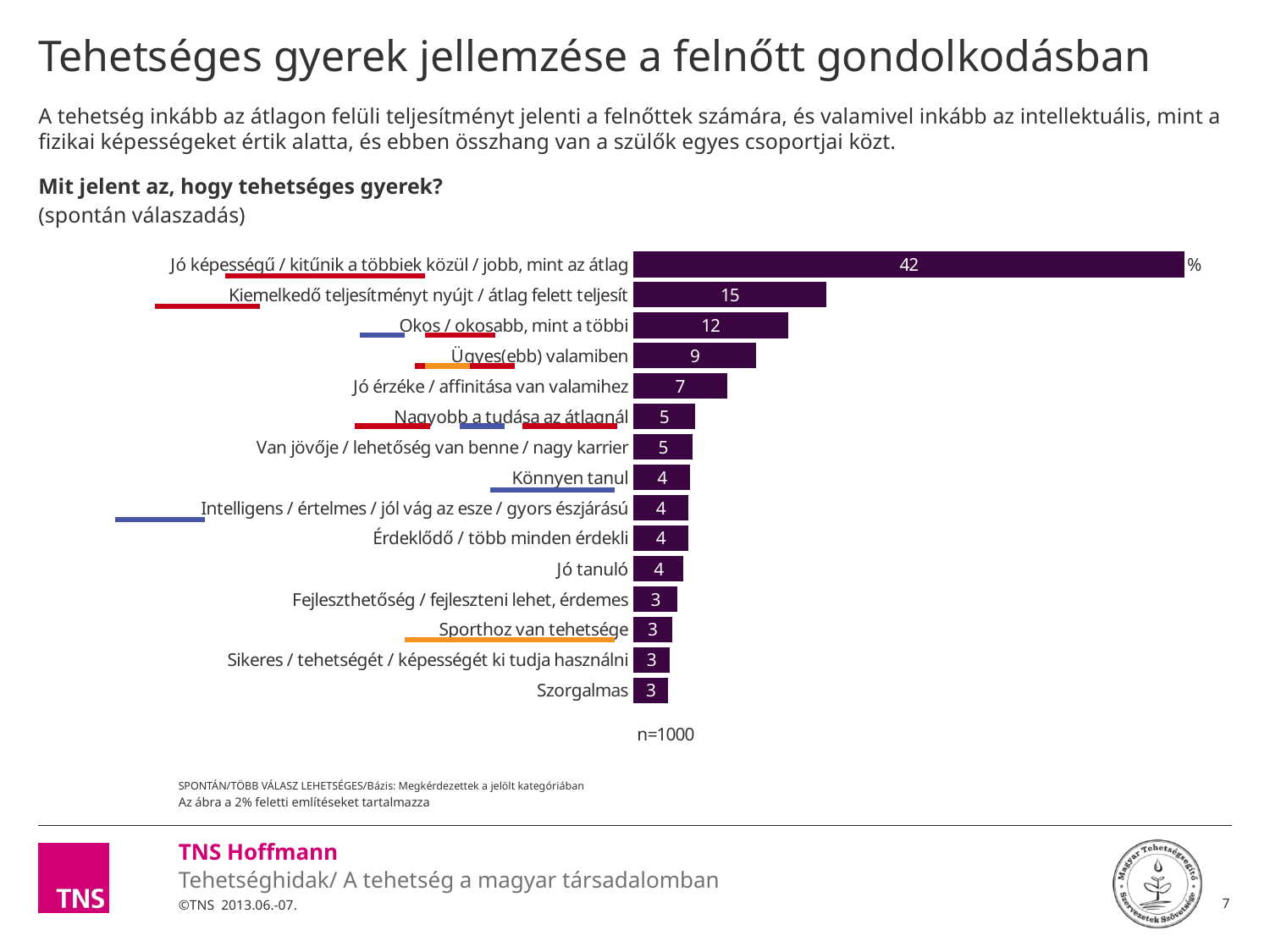
What value is shown for "Kiemelkedő teljesítményt nyújt / átlag felett teljesít"? 15 What sample size (n) is stated below the chart? n=1000 What value is shown for "Ügyes(ebb) valamiben"? 9 What value is shown for "Okos / okosabb, mint a többi"? 12 How many categories are shown in the chart? 15 Which is larger: the value for "Kiemelkedő teljesítményt nyújt / átlag felett teljesít" or the value for "Okos / okosabb, mint a többi"? Kiemelkedő teljesítményt nyújt / átlag felett teljesít What value is shown for "Jó képességű / kitűnik a többiek közül / jobb, mint az átlag"? 42 Which category has the highest value in the chart? Jó képességű / kitűnik a többiek közül / jobb, mint az átlag What is the difference between the values for "Okos / okosabb, mint a többi" and "Ügyes(ebb) valamiben"? 3 What is the difference between the values for "Jó képességű / kitűnik a többiek közül / jobb, mint az átlag" and "Kiemelkedő teljesítményt nyújt / átlag felett teljesít"? 27 What value is shown for "Jó érzéke / affinitása van valamihez"? 7 What kind of chart is shown on the slide? Bar chart